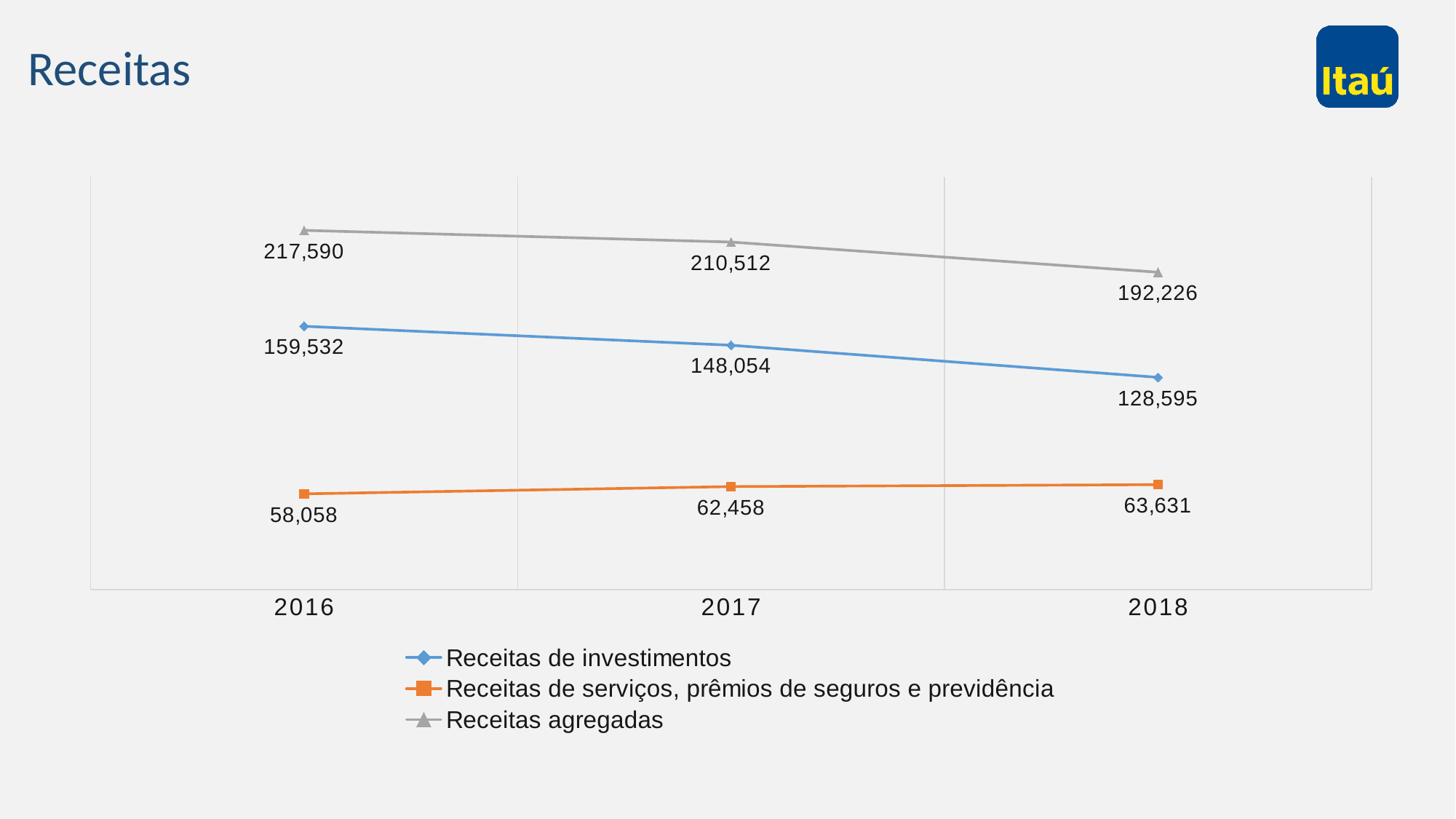
What is the value of Receitas de serviços, prêmios de seguros e previdência in 2017? 62,458 In which year is Receitas agregadas highest? 2016 How many series does the legend list? 3 Which is larger in 2018: Receitas de investimentos or Receitas de serviços, prêmios de seguros e previdência? Receitas de investimentos In which year is Receitas de serviços, prêmios de seguros e previdência lowest? 2016 What is the difference between Receitas de investimentos in 2016 and in 2018? 30,937 What kind of chart is shown on the slide? Line chart What is the difference between Receitas agregadas and Receitas de investimentos in 2017? 62,458 What is the value of Receitas de investimentos in 2016? 159,532 How many years are shown on the x axis? 3 Does Receitas de investimentos rise or fall from 2016 to 2018? Fall What is the value of Receitas agregadas in 2018? 192,226